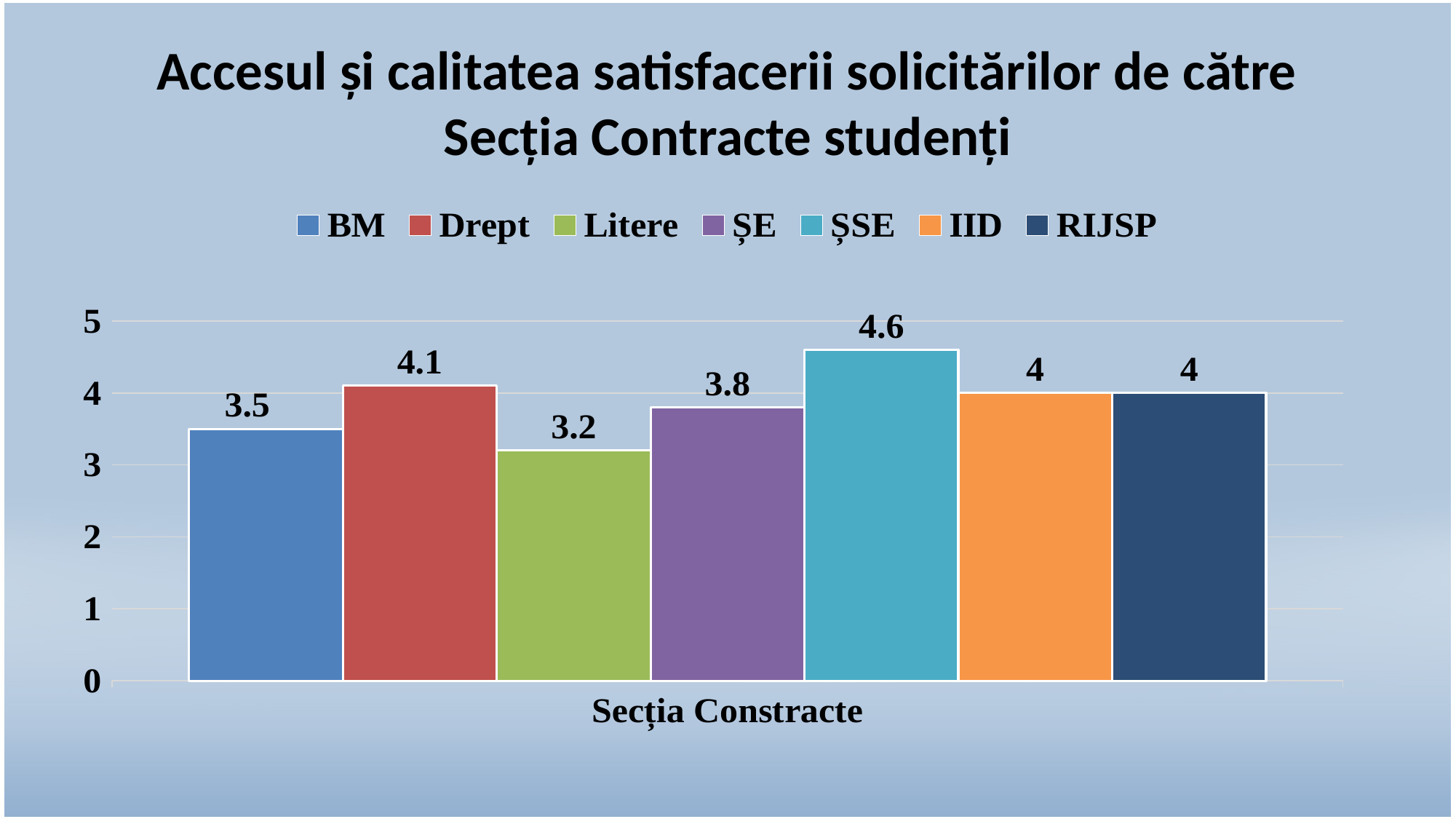
How many series does the legend list? 7 What is the value for Litere? 3.2 What is the difference between the values for ȘSE and BM? 1.1 Which series has the lowest value? Litere What kind of chart is shown on the slide? bar chart Which is larger, the value for Drept or the value for ȘE? Drept What is the value for ȘE? 3.8 What is the value for Drept? 4.1 What is the label on the x axis of the chart? Secția Constracte How many bars are plotted in the chart? 7 Is the value for BM greater or less than 4? less Which series has the highest value? ȘSE